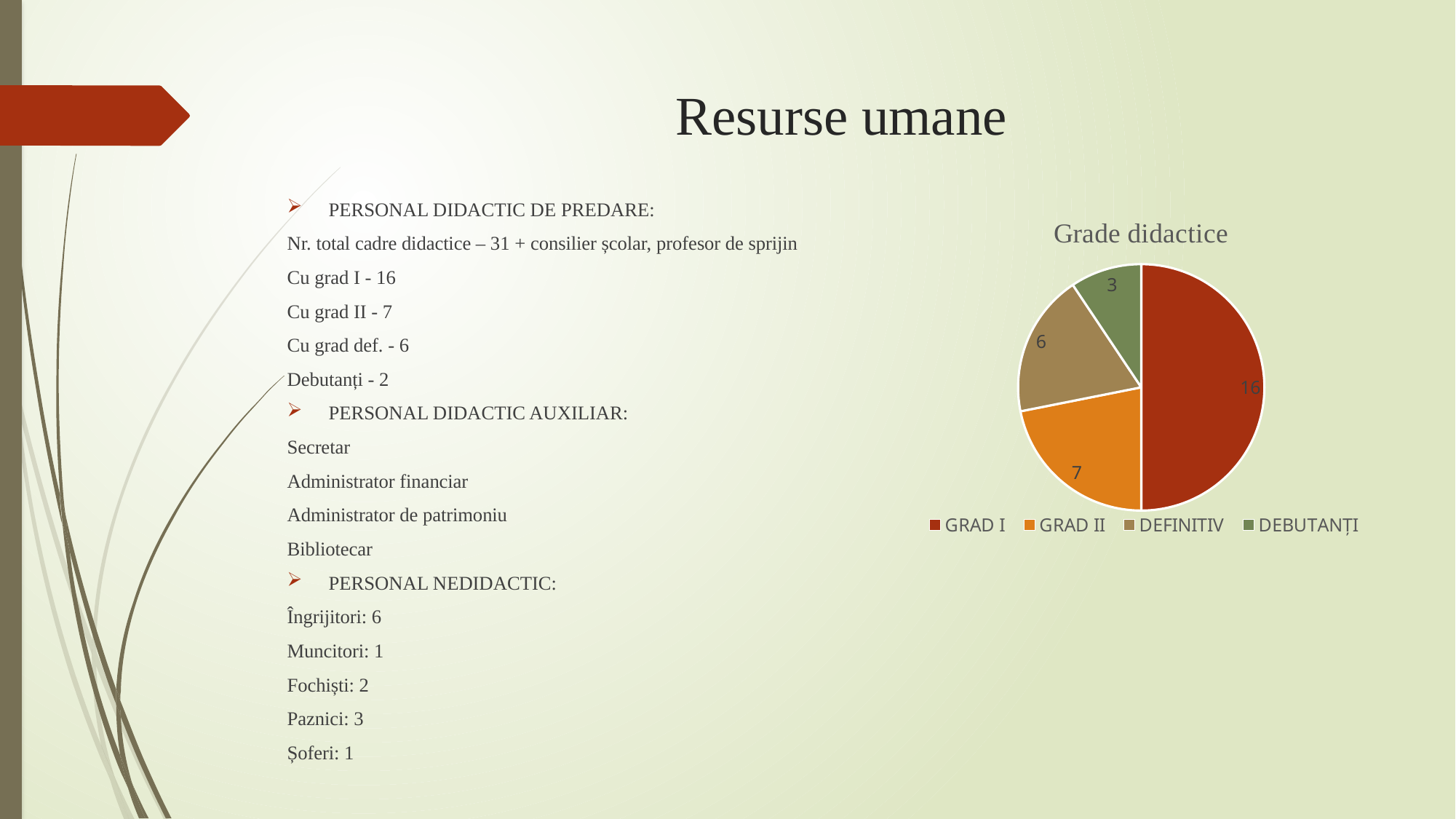
What type of chart is shown on the slide? pie chart What is the value for GRAD II in the pie chart? 7 Which is larger, the value for GRAD II or the value for DEFINITIV? GRAD II How many categories does the legend of the pie chart list? 4 What is the title of the chart? Grade didactice What is the value for GRAD I in the pie chart? 16 What is the difference between the values for GRAD I and GRAD II? 9 Which category has the smallest slice in the pie chart? DEBUTANȚI What is the value for DEBUTANȚI in the pie chart? 3 What is the value for DEFINITIV in the pie chart? 6 What share of the pie does GRAD I represent? 50% Which category has the largest slice in the pie chart? GRAD I